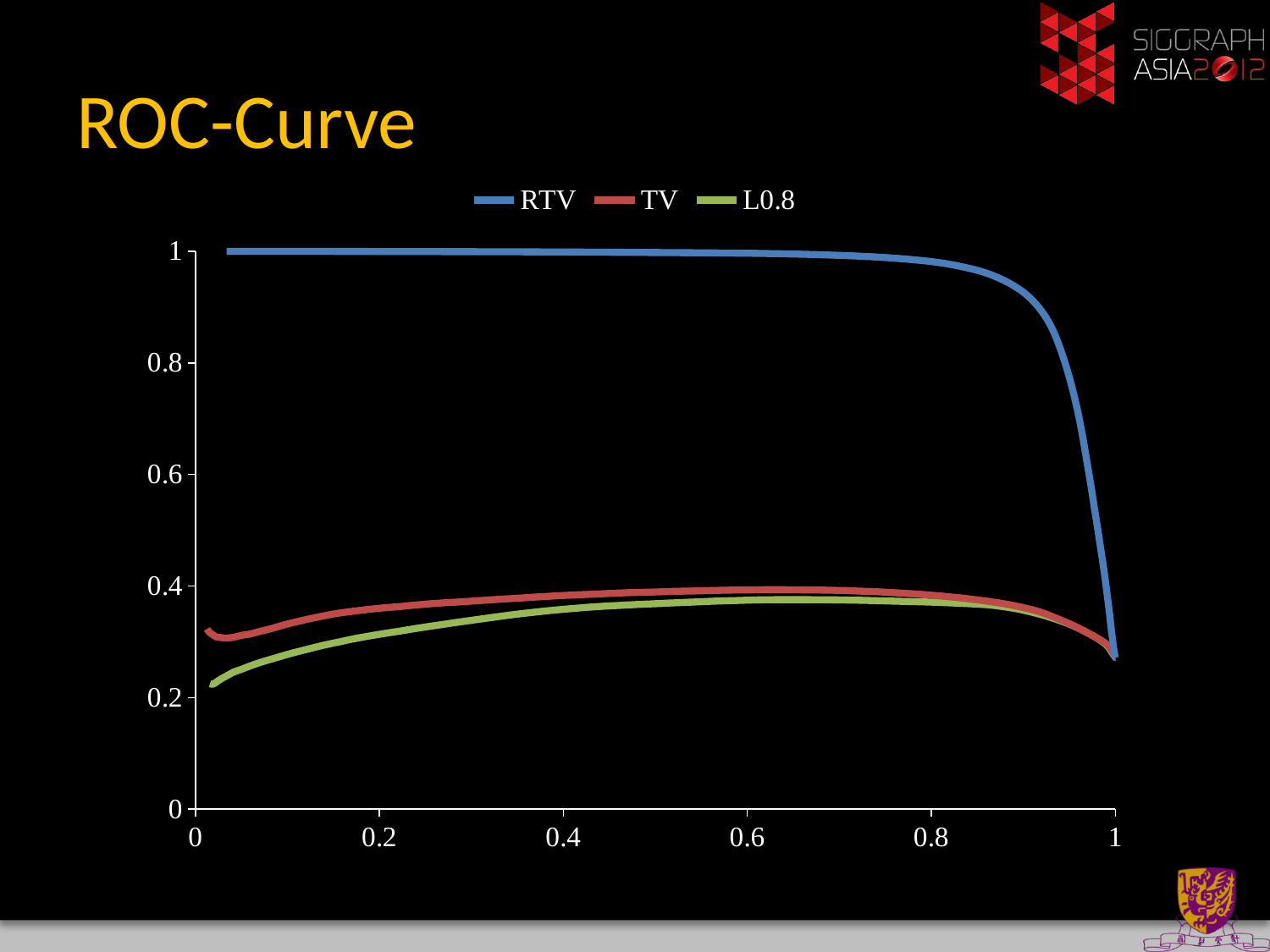
At x = 0.2, which series has the larger value, TV or L0.8? TV At x = 0.4, which series has the larger value, RTV or TV? RTV What kind of chart is shown on the slide? line chart Which colour is used for the RTV series? blue How many series does the legend list? 3 Is the value of the RTV curve at x = 0.5 greater or less than 0.8? greater What is the title of the chart? ROC-Curve Is the value of the L0.8 curve at x = 0.2 greater or less than 0.4? less Which series has the highest value at x = 0.5? RTV Does the RTV curve rise or fall as x goes from 0.8 to 1? fall Is the value of the RTV curve at x = 0.2 greater or less than 0.8? greater